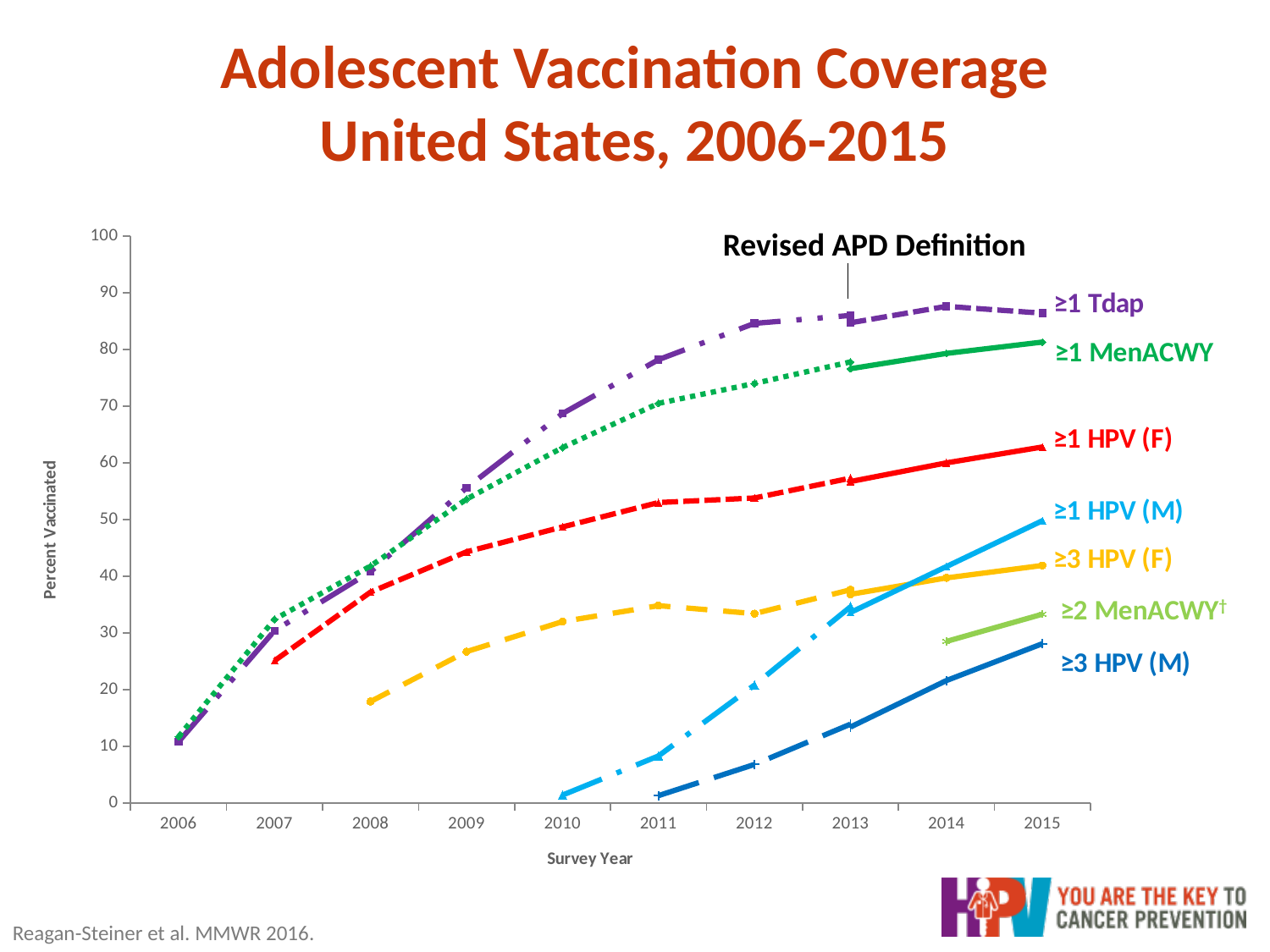
At which survey year is the 'Revised APD Definition' annotation placed? 2013 Which series has the lowest coverage in 2015? ≥3 HPV (M) Does the ≥1 Tdap series rise or fall from 2006 to 2015? rise Does the ≥1 HPV (M) series rise or fall from 2010 to 2015? rise What kind of chart is shown on the slide? line chart How many series are labelled on the chart? 7 In 2015, which is larger: ≥1 HPV (F) or ≥1 HPV (M)? ≥1 HPV (F) Is the value for ≥1 MenACWY in 2015 greater or less than 70? greater Is the value for ≥1 Tdap in 2015 greater or less than 80? greater Which series has the highest coverage in 2015? ≥1 Tdap How many survey years are shown on the x axis? 10 Is the value for ≥3 HPV (M) in 2014 greater or less than 30? less